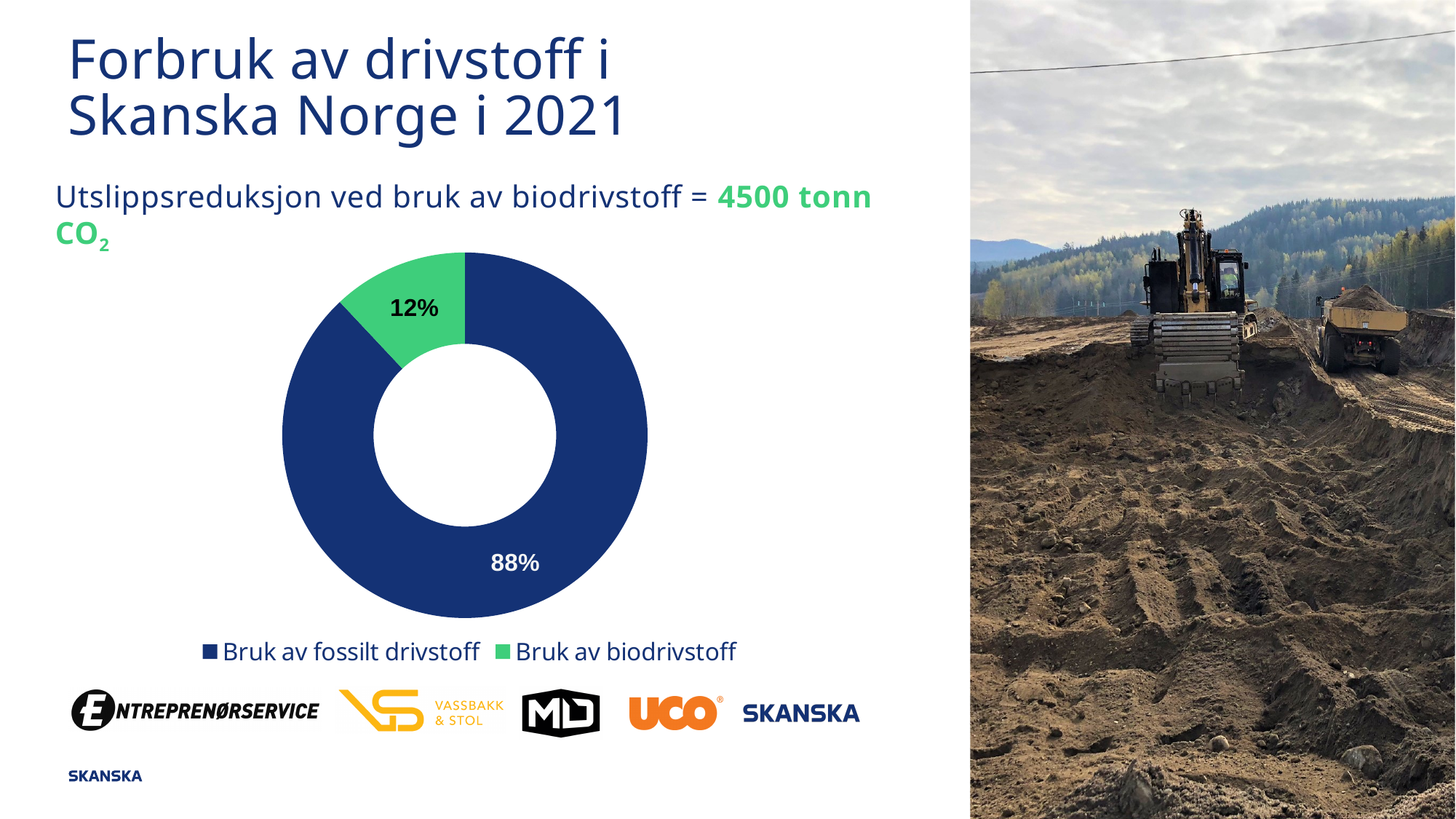
What share of fuel use does 'Bruk av fossilt drivstoff' account for? 88% Which is larger: the share for 'Bruk av fossilt drivstoff' or for 'Bruk av biodrivstoff'? Bruk av fossilt drivstoff What kind of chart is shown on the slide? Pie chart (doughnut) What colour represents 'Bruk av biodrivstoff' in the chart? Green How many categories does the chart show? 2 How many entries does the legend list? 2 What colour represents 'Bruk av fossilt drivstoff' in the chart? Dark blue Which category has the largest share of the chart? Bruk av fossilt drivstoff What is the difference in percentage points between 'Bruk av fossilt drivstoff' and 'Bruk av biodrivstoff'? 76 percentage points What share of fuel use does 'Bruk av biodrivstoff' account for? 12% Which category has the smallest share of the chart? Bruk av biodrivstoff What is the total of the two shares shown in the chart? 100%